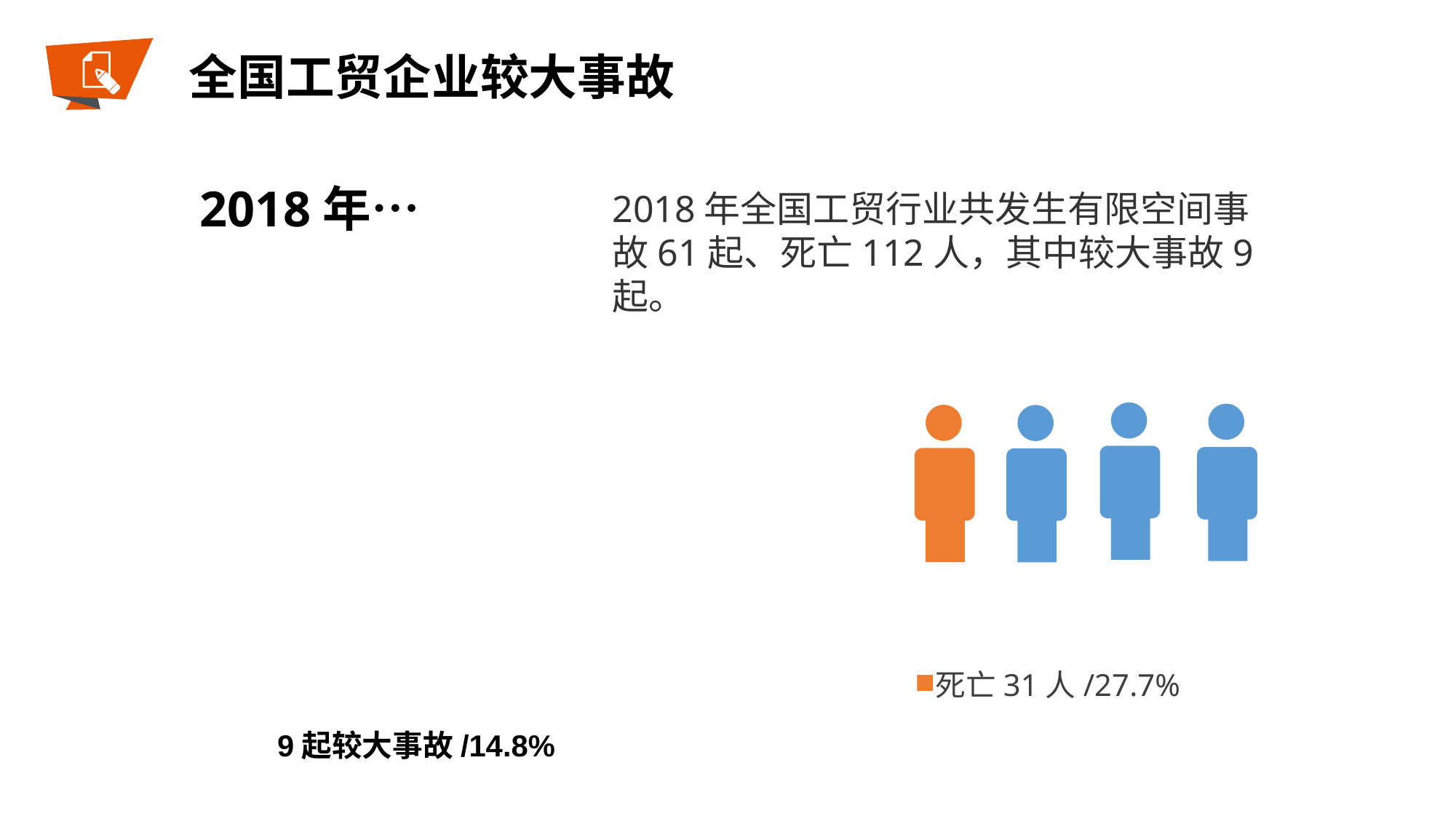
How many of the person icons are orange? 1 How many person icons are shown in the pictogram chart? 4 How many of the person icons are blue? 3 What percentage is shown in the legend for 死亡 31 人? 27.7% What is the difference in percentage points between 27.7% (死亡 31 人) and 14.8% (9 起较大事故)? 12.9 What colour is the icon that corresponds to the legend entry 死亡 31 人? Orange Which percentage is larger, the one for 死亡 31 人 or the one for 9 起较大事故? 死亡 31 人 (27.7%) How many series does the legend list? 1 How many deaths (死亡) does the legend entry state? 31 人 What kind of chart is used to show the 死亡 31 人 figure? Pictogram (person icon) chart What does the legend entry below the person icons read? 死亡 31 人 /27.7% What percentage is shown next to 9 起较大事故? 14.8%